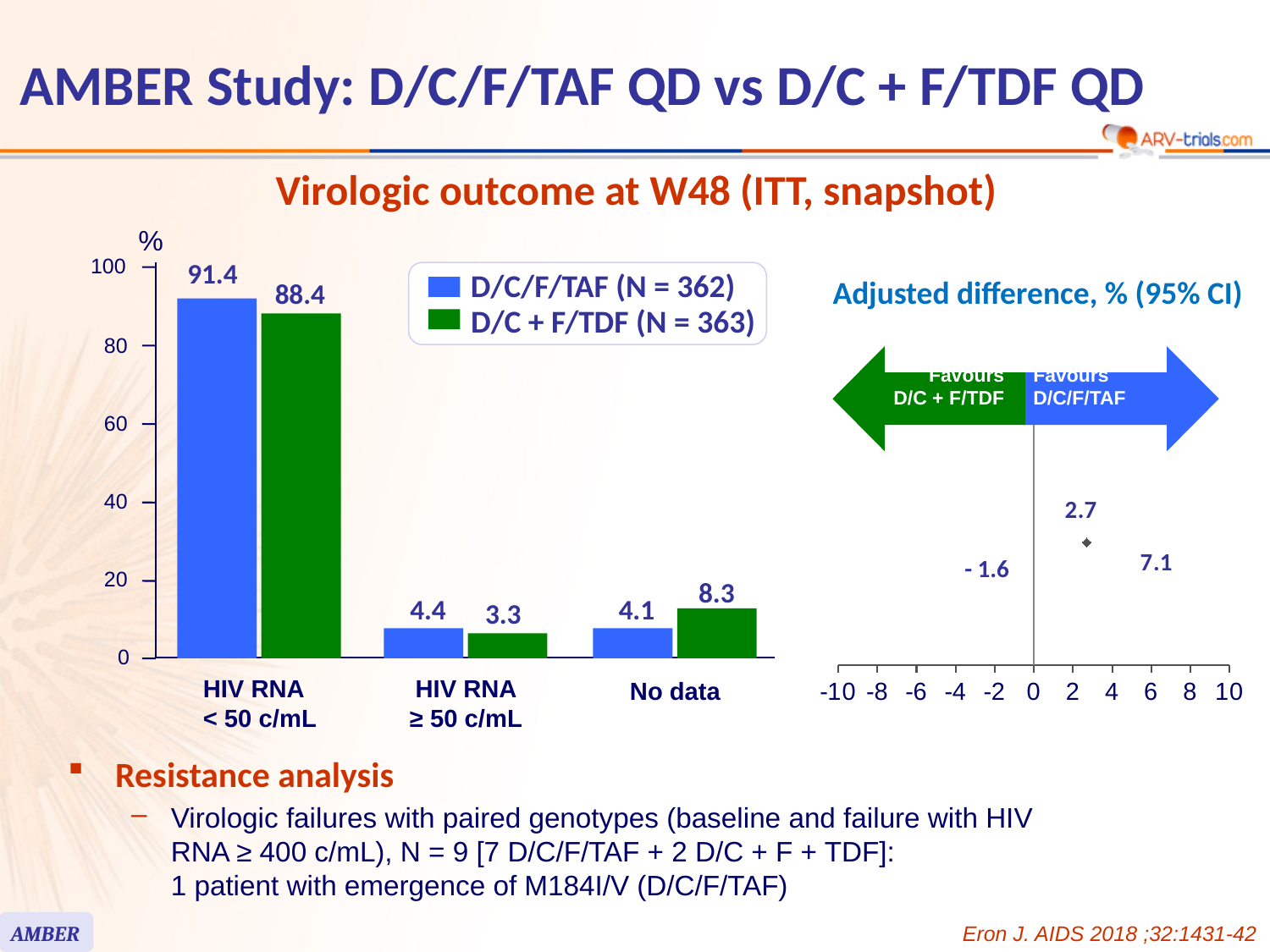
In the bar chart on the left, how many categories are shown on the x axis? 3 In the bar chart on the left, which category has the lowest value for D/C + F/TDF? HIV RNA ≥ 50 c/mL In the bar chart on the left, what is the value for D/C + F/TDF in the No data category? 8.3 In the bar chart on the left, how many series does the legend list? 2 In the bar chart on the left, what is the difference between D/C/F/TAF and D/C + F/TDF in the HIV RNA < 50 c/mL category? 3.0 In the bar chart on the left, which category has the highest value for D/C/F/TAF? HIV RNA < 50 c/mL In the adjusted difference plot on the right, what are the lower and upper limits of the 95% CI? -1.6 and 7.1 In the bar chart on the left, what is the value for D/C + F/TDF in the HIV RNA ≥ 50 c/mL category? 3.3 In the bar chart on the left, what is the value for D/C/F/TAF in the HIV RNA < 50 c/mL category? 91.4 What kind of chart is shown on the left of the slide? Bar chart In the bar chart on the left, which series has the larger value in the No data category? D/C + F/TDF In the adjusted difference plot on the right, what is the point estimate of the adjusted difference? 2.7